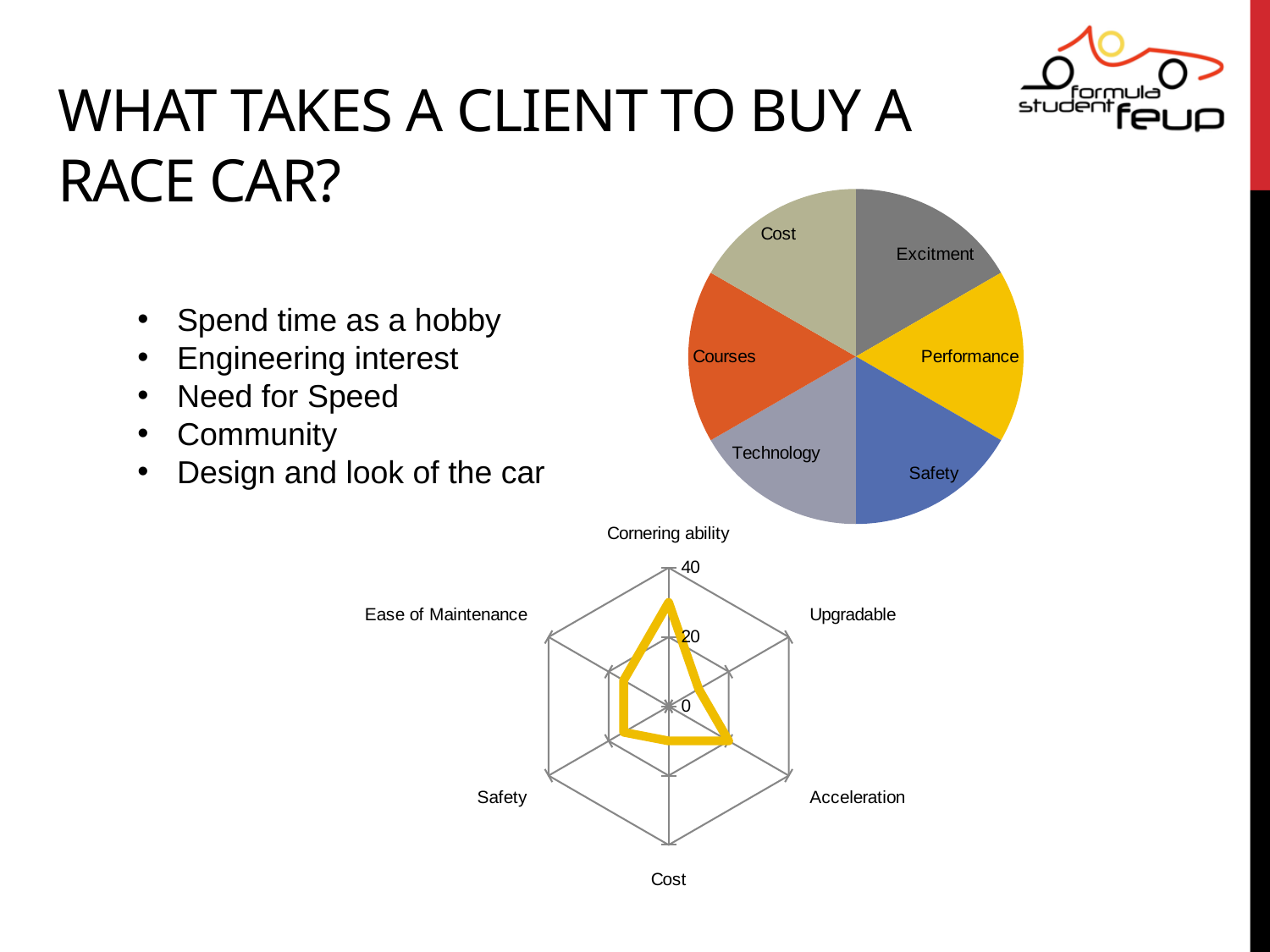
In the radar chart, is the value for Cornering ability greater or less than 20? greater What kind of chart is the chart at the bottom of the slide? radar chart How many slices does the pie chart have? 6 In the radar chart, is the value for Cost greater or less than 20? less In the radar chart, which is larger, the value for Cornering ability or the value for Safety? Cornering ability In the pie chart, which slice is coloured dark grey? Excitment In the radar chart, is the value for Cornering ability greater or less than 40? less How many categories (axes) does the radar chart have? 6 What kind of chart is the chart in the top right of the slide? pie chart In the radar chart, which category has the highest value? Cornering ability What is the highest tick value shown on the radar chart's axis? 40